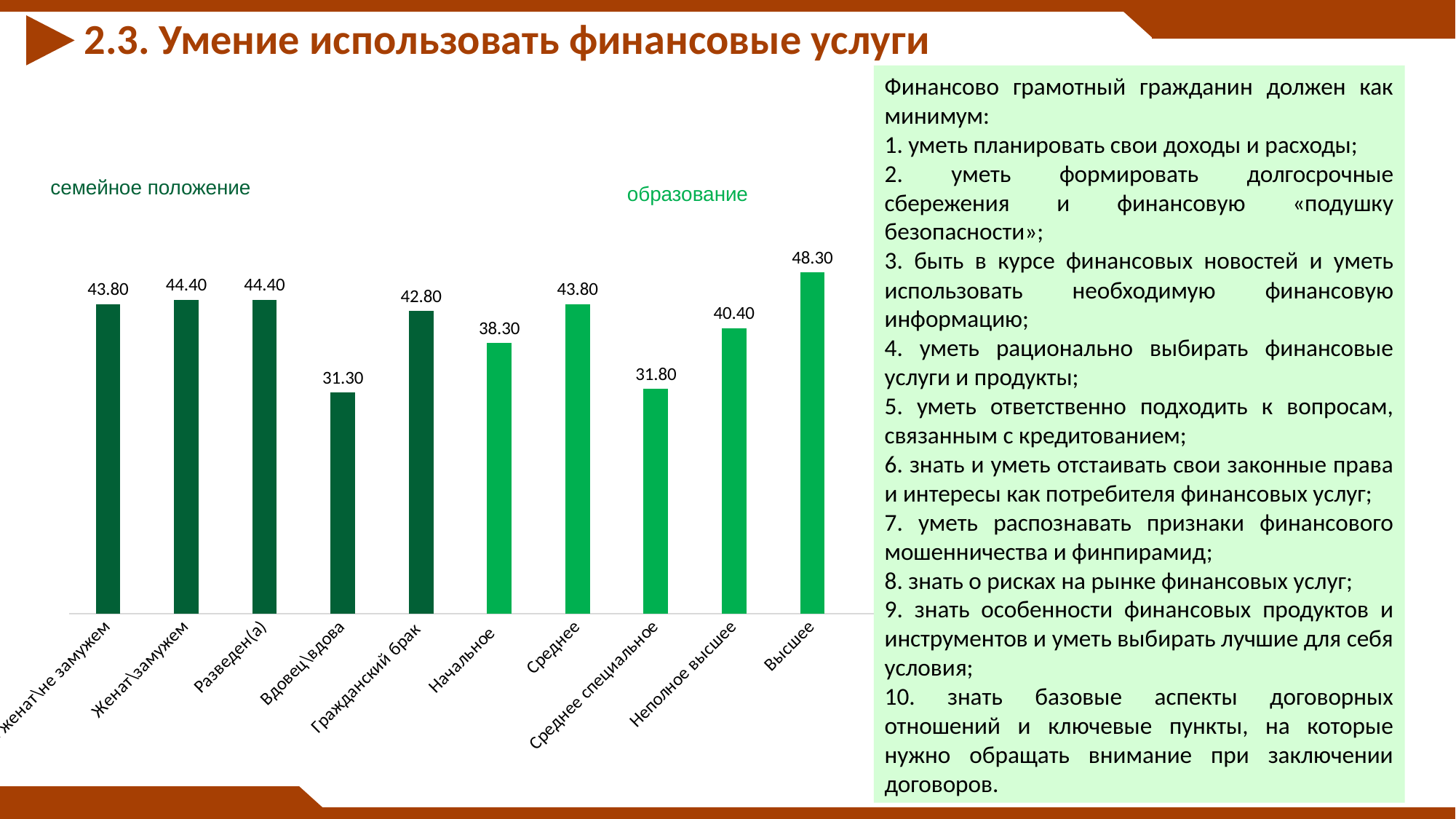
What are the two group labels shown above the chart? семейное положение and образование What is the value for Среднее специальное? 31.80 Which category has the highest value? Высшее What is the value for Вдовец\вдова? 31.30 What is the value for Неполное высшее? 40.40 Which category has the lowest value? Вдовец\вдова How many bars are shown in the chart? 10 What is the value for Высшее? 48.30 What is the value for Гражданский брак? 42.80 Which is larger, the value for Разведен(а) or the value for Начальное? Разведен(а) What is the difference between the values for Высшее and Начальное? 10.00 What type of chart is shown on the slide? bar chart